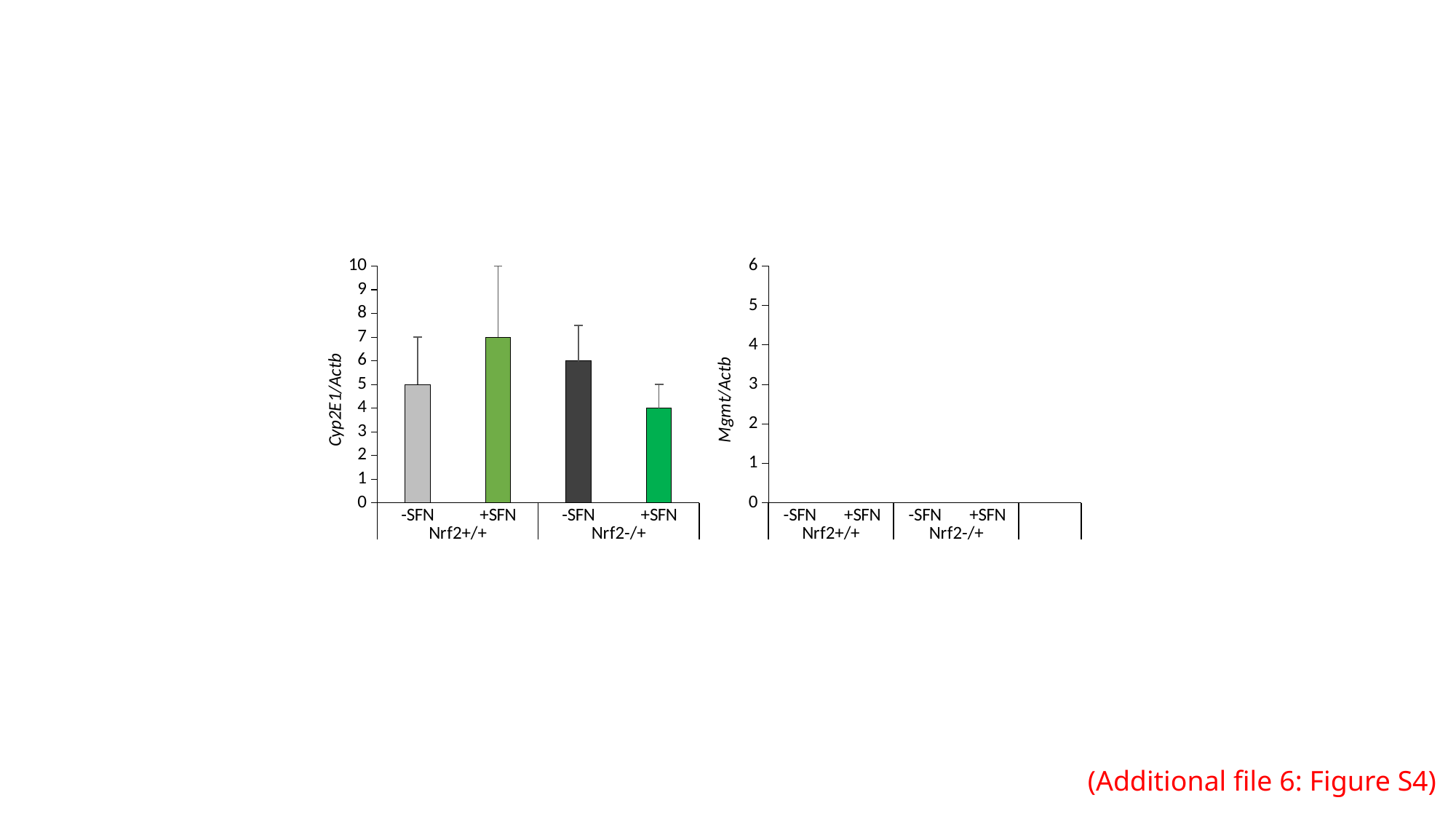
What is the y-axis label of the left chart? Cyp2E1/Actb What kind of chart is the left chart (Cyp2E1/Actb)? bar chart In the left chart (Cyp2E1/Actb), which bar is the lowest? +SFN, Nrf2-/+ What is the maximum value shown on the y axis of the right chart (Mgmt/Actb)? 6 In the left chart (Cyp2E1/Actb), what is the value for +SFN in the Nrf2-/+ group? 4 In the left chart (Cyp2E1/Actb), how many bars are plotted? 4 In the left chart (Cyp2E1/Actb), what is the value for -SFN in the Nrf2+/+ group? 5 In the left chart (Cyp2E1/Actb), what is the value for -SFN in the Nrf2-/+ group? 6 In the left chart (Cyp2E1/Actb), which is larger: -SFN in Nrf2-/+ or +SFN in Nrf2-/+? -SFN in Nrf2-/+ In the left chart (Cyp2E1/Actb), what is the difference between the +SFN and -SFN values in the Nrf2+/+ group? 2 In the left chart (Cyp2E1/Actb), what is the value for +SFN in the Nrf2+/+ group? 7 In the left chart (Cyp2E1/Actb), which bar is the highest? +SFN, Nrf2+/+